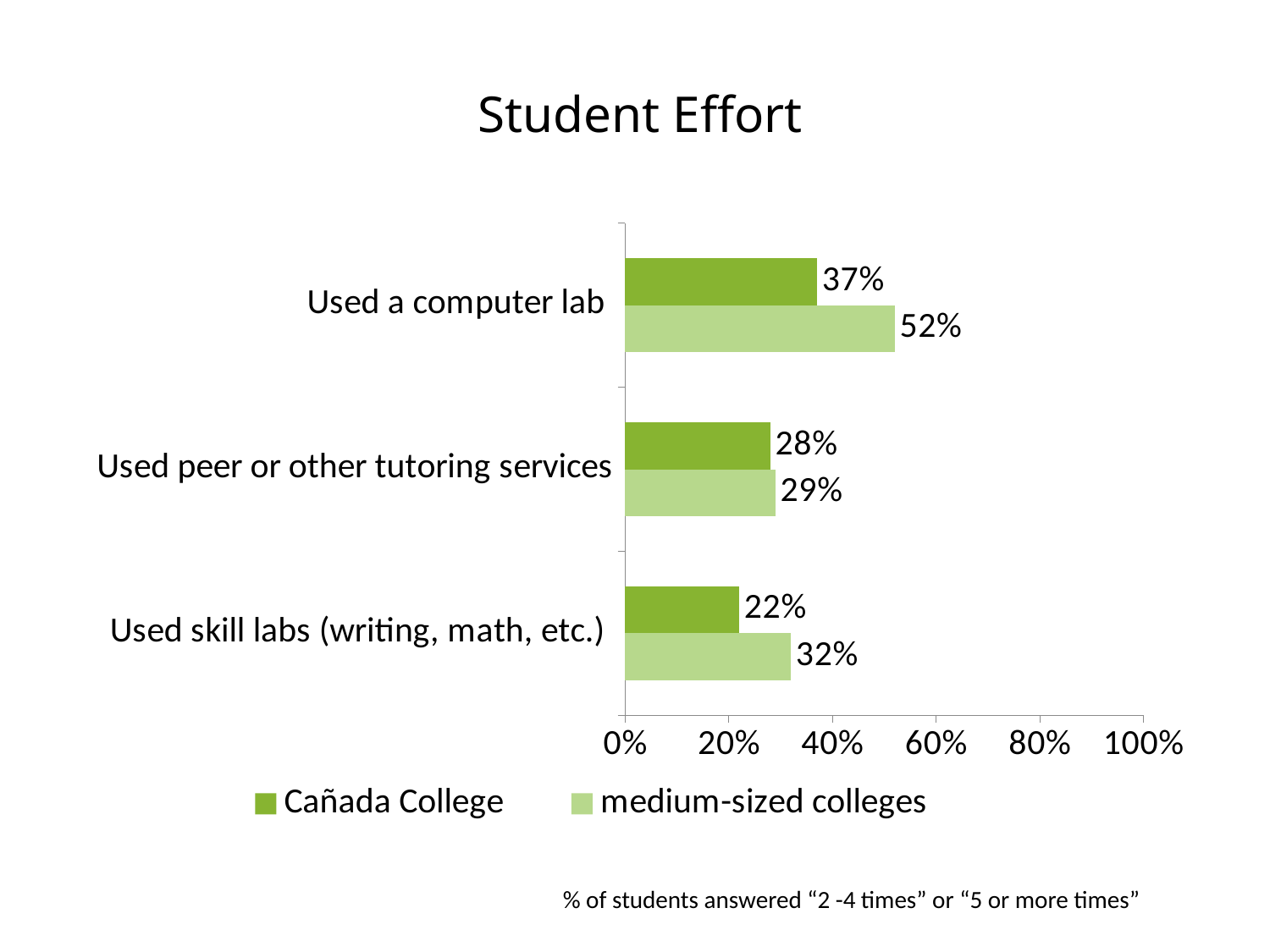
What is the title of the chart? Student Effort How many series does the legend list? 2 What is the value for medium-sized colleges for 'Used skill labs (writing, math, etc.)'? 32% What is the difference between medium-sized colleges and Cañada College for 'Used skill labs (writing, math, etc.)'? 10% What is the value for medium-sized colleges for 'Used peer or other tutoring services'? 29% Which category has the lowest value for Cañada College? Used skill labs (writing, math, etc.) What kind of chart is shown on the slide? bar chart Which category has the highest value for Cañada College? Used a computer lab How many categories are shown on the chart? 3 What is the difference between medium-sized colleges and Cañada College for 'Used a computer lab'? 15% For 'Used a computer lab', which is larger: Cañada College or medium-sized colleges? medium-sized colleges What percentage of Cañada College students used a computer lab? 37%